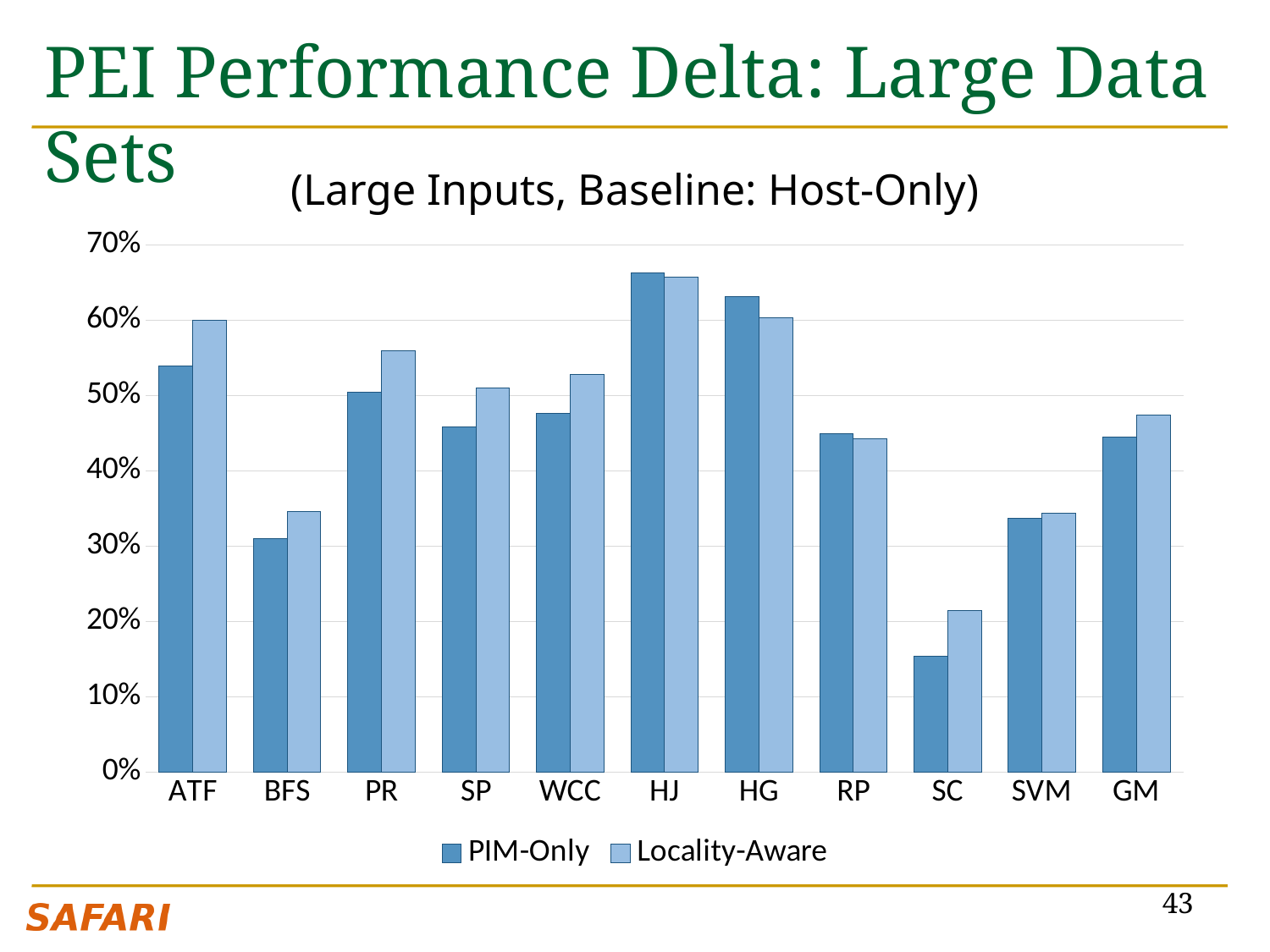
What kind of chart is shown on the slide? bar chart For ATF, which series has the larger value, PIM-Only or Locality-Aware? Locality-Aware Which category has the lowest Locality-Aware value? SC Which category has the highest PIM-Only value? HJ Is the PIM-Only value for ATF greater or less than 50%? greater Is the Locality-Aware value for PR greater or less than 50%? greater How many categories are shown on the x axis? 11 Is the Locality-Aware value for BFS greater or less than 40%? less What are the two legend entries of the chart? PIM-Only and Locality-Aware How many series does the legend list? 2 Which category has the lowest PIM-Only value? SC